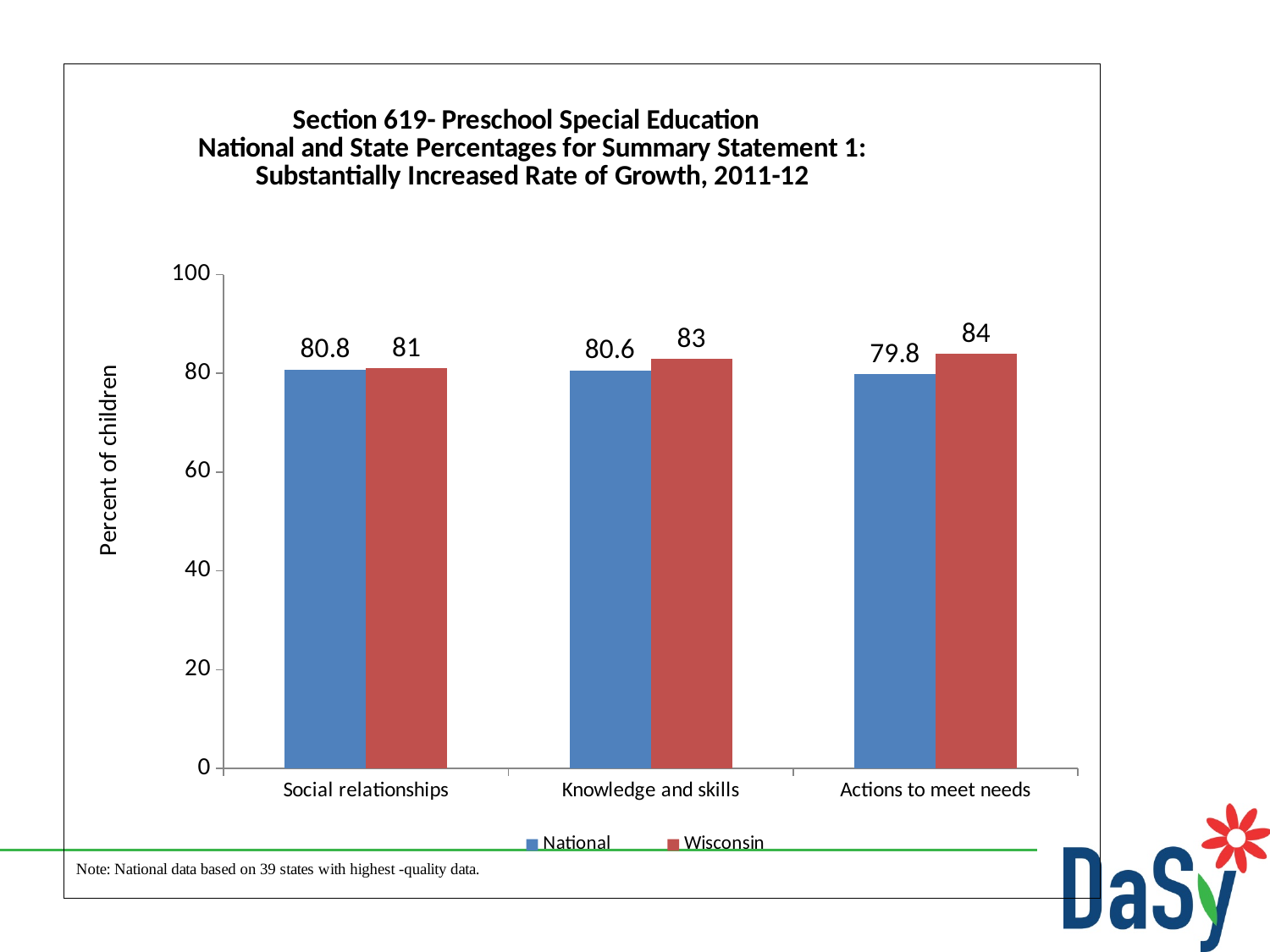
What is the Wisconsin value for Actions to meet needs? 84 What is the Wisconsin value for Knowledge and skills? 83 Which category has the highest Wisconsin value? Actions to meet needs How many categories are shown on the x axis? 3 What kind of chart is shown on the slide? Bar chart What is the difference between the Wisconsin and National values for Actions to meet needs? 4.2 What is the difference between the Wisconsin and National values for Knowledge and skills? 2.4 What is the National value for Actions to meet needs? 79.8 Which is larger for Knowledge and skills, the National value or the Wisconsin value? Wisconsin Which category has the lowest National value? Actions to meet needs How many series does the legend list? 2 What is the National value for Social relationships? 80.8